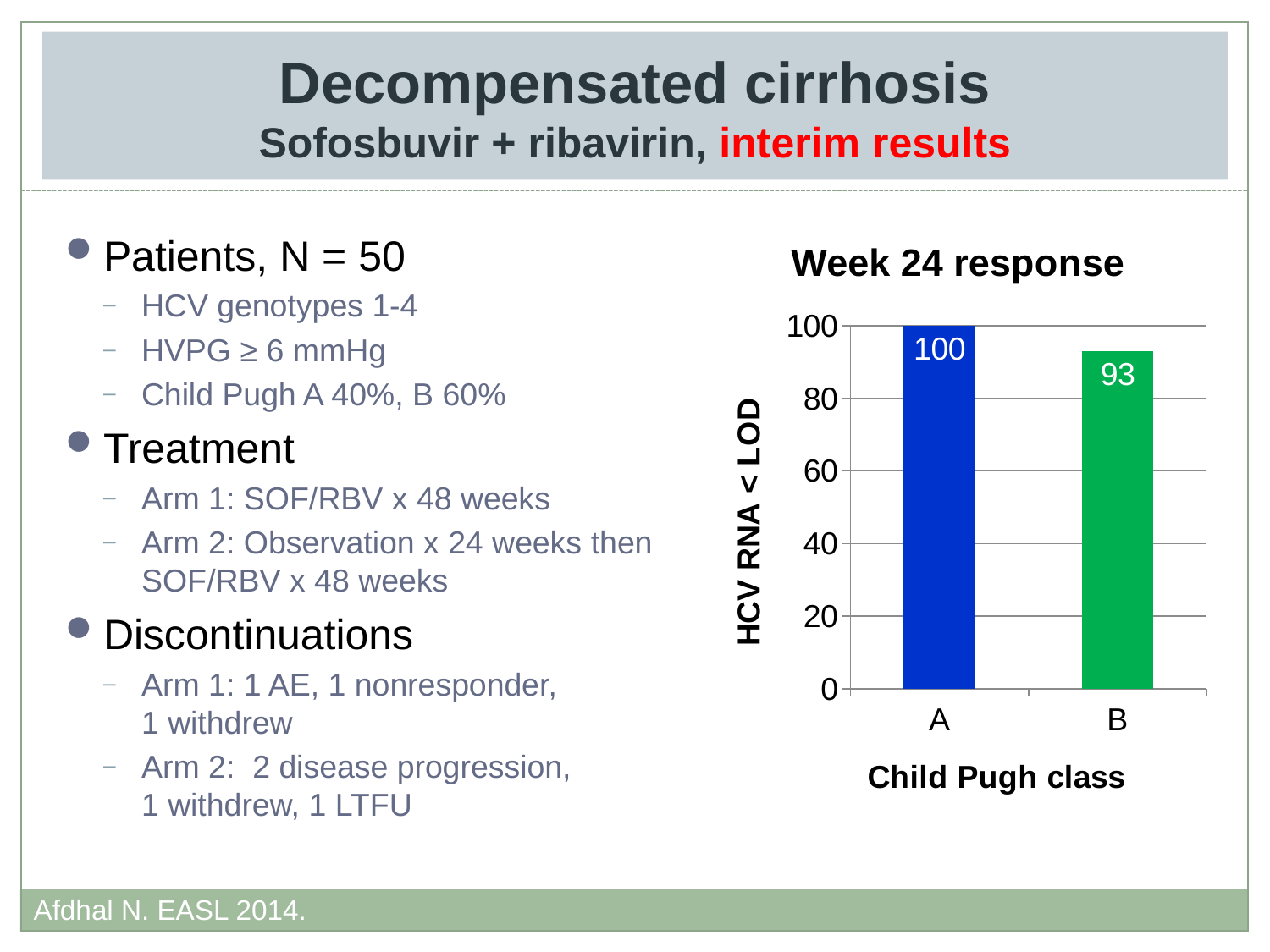
What is the label of the y axis of the chart? HCV RNA < LOD Which Child Pugh class has the lowest Week 24 response? B What is the title of the chart? Week 24 response Which is larger, the value for Child Pugh class A or class B? A What is the value for Child Pugh class A in the Week 24 response chart? 100 What is the label of the x axis of the chart? Child Pugh class Which Child Pugh class has the highest Week 24 response? A What is the difference between the values for Child Pugh class A and class B? 7 What is the value for Child Pugh class B in the Week 24 response chart? 93 What kind of chart is shown on the slide? bar chart Is the value for Child Pugh class B greater or less than 80? greater How many categories are shown on the x axis of the chart? 2